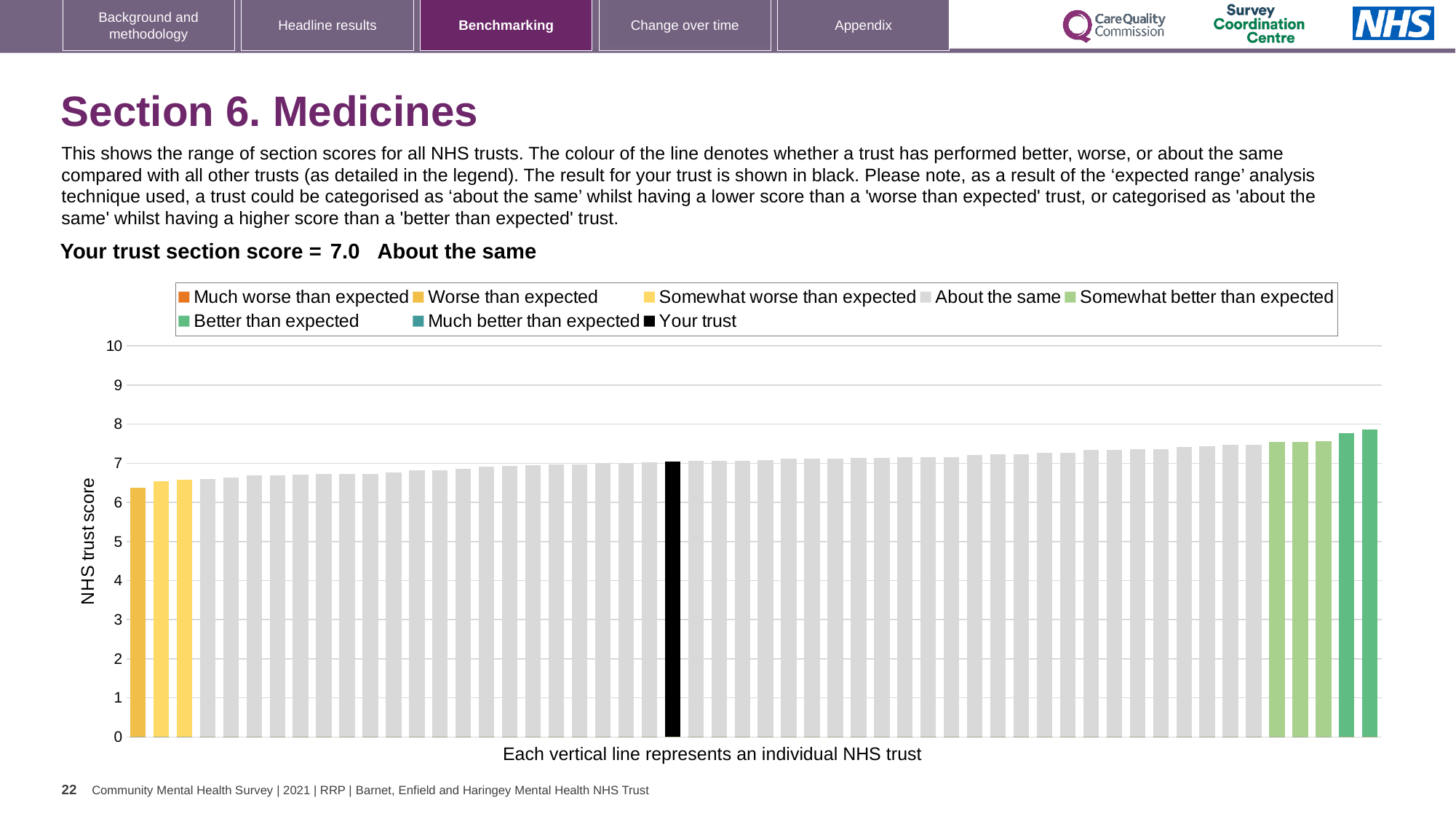
Is the value of the leftmost (lowest) bar greater or less than 7? less Is the value of the black 'Your trust' bar greater or less than 6? greater What is the trust section score shown on the slide? 7.0 Is the value of the rightmost (highest) bar greater or less than 7? greater What kind of chart is shown on the slide? bar chart Which is larger, the rightmost bar or the black 'Your trust' bar? the rightmost bar What is the label on the vertical axis of the chart? NHS trust score Do the bar values rise or fall from left to right along the x axis? rise How many entries does the chart legend list? 8 What category is the trust's section score placed in, as stated next to the score? About the same What does the caption below the x axis say each vertical line represents? an individual NHS trust